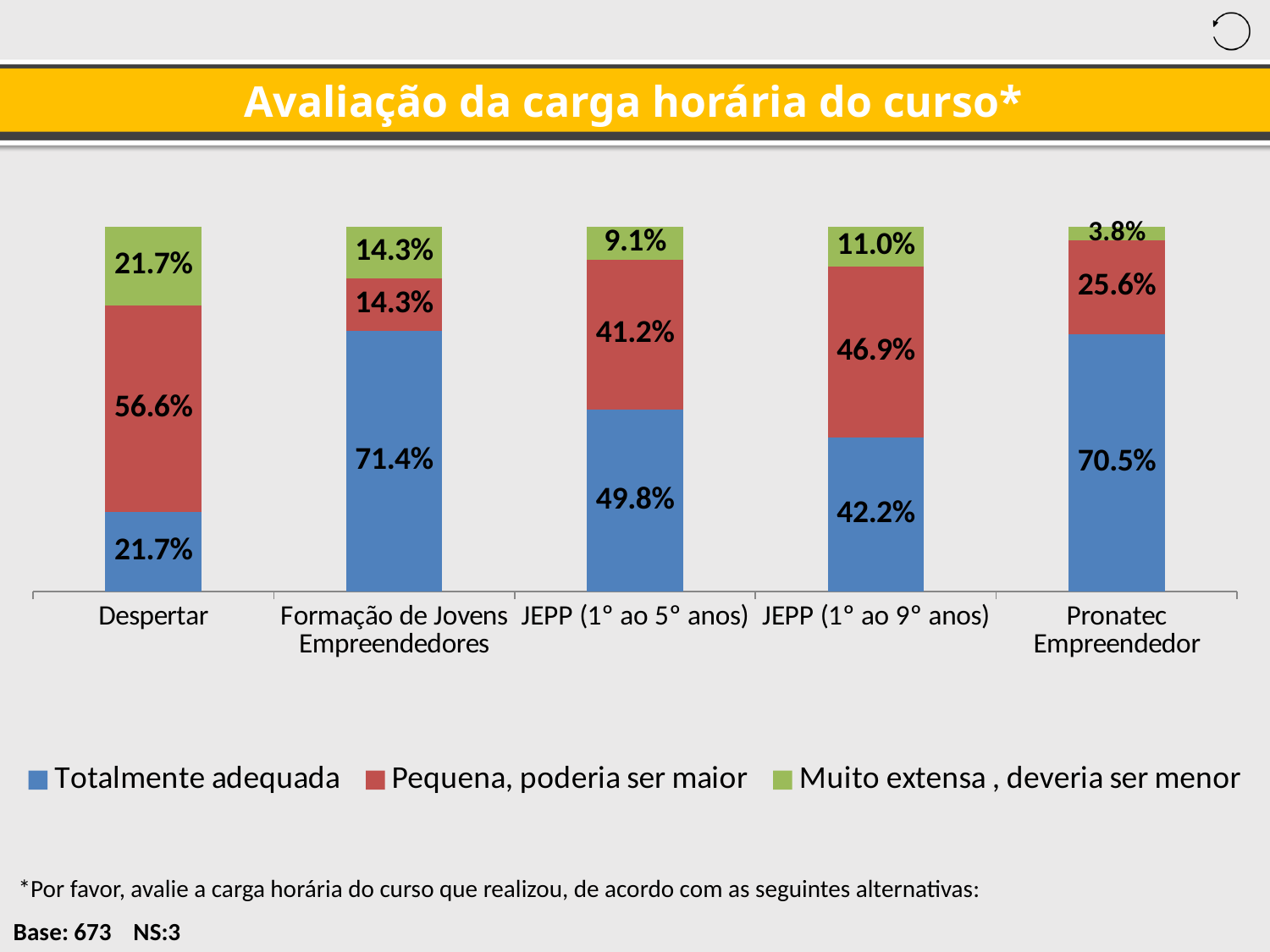
How many series does the legend list? 3 What is the title of the chart? Avaliação da carga horária do curso* What is the value of 'Pequena, poderia ser maior' for JEPP (1° ao 9° anos)? 46.9% Which course has the highest share of 'Pequena, poderia ser maior'? Despertar What kind of chart is shown on the slide? Stacked bar chart For JEPP (1° ao 9° anos), which is larger: 'Totalmente adequada' or 'Pequena, poderia ser maior'? Pequena, poderia ser maior How many courses are shown on the x axis of the chart? 5 Which course has the lowest share of 'Muito extensa, deveria ser menor'? Pronatec Empreendedor Which course has the highest share of 'Totalmente adequada'? Formação de Jovens Empreendedores What is the value of 'Muito extensa, deveria ser menor' for Pronatec Empreendedor? 3.8% What percentage of respondents rated the course load as 'Totalmente adequada' for Formação de Jovens Empreendedores? 71.4% For Despertar, what is the difference between 'Pequena, poderia ser maior' and 'Totalmente adequada'? 34.9 percentage points